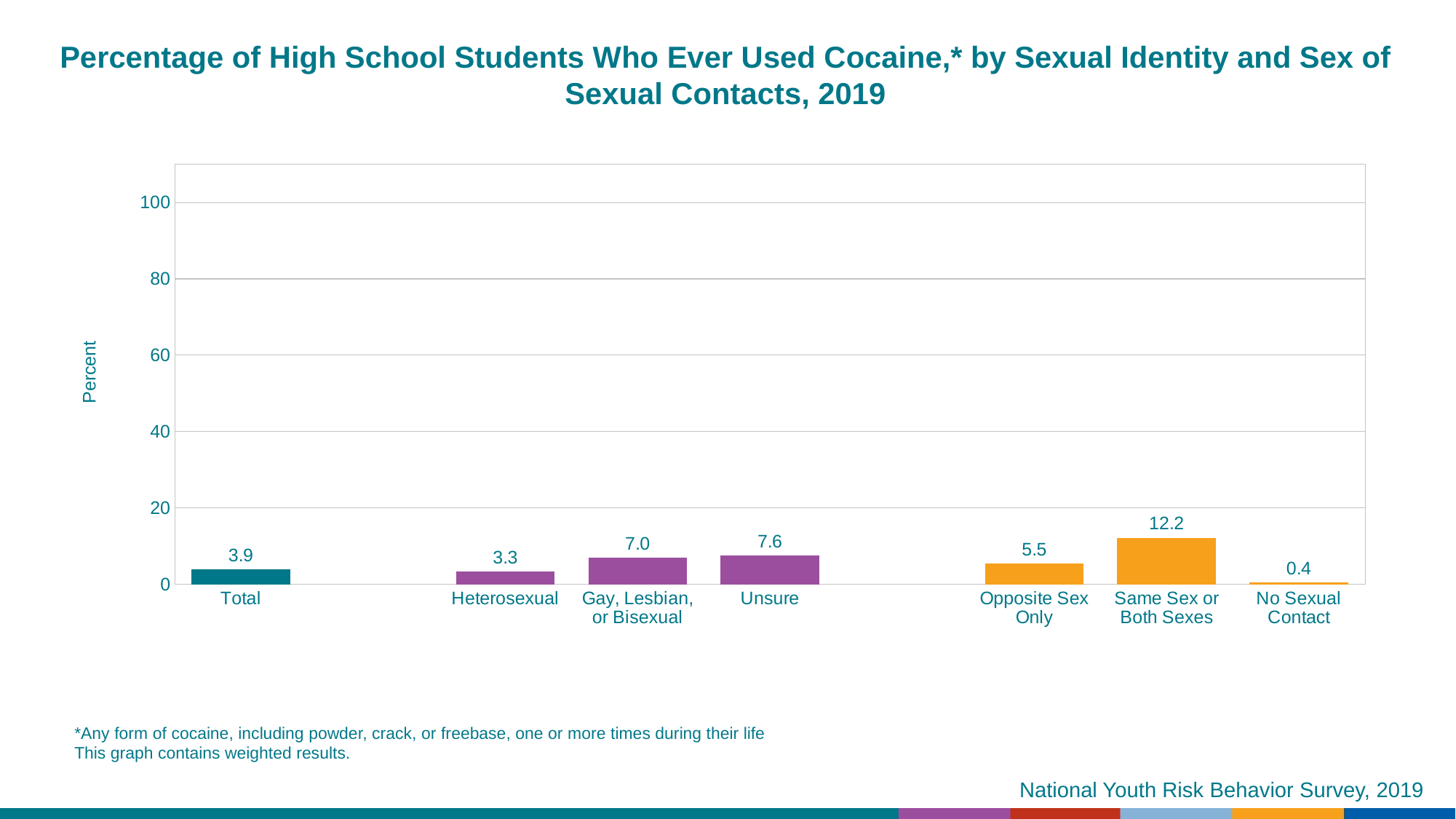
What kind of chart is this? Bar chart Which is larger, the value for Unsure or the value for Heterosexual? Unsure What is the value for Total? 3.9 What is the difference between the values for Same Sex or Both Sexes and Opposite Sex Only? 6.7 What is the value for students with No Sexual Contact? 0.4 Is the value for Same Sex or Both Sexes greater or less than 20? less Which category has the highest value? Same Sex or Both Sexes What is the value for Heterosexual students? 3.3 Which category has the lowest value? No Sexual Contact How many categories are shown on the x axis? 7 What is the label of the y axis? Percent What is the value for Gay, Lesbian, or Bisexual students? 7.0